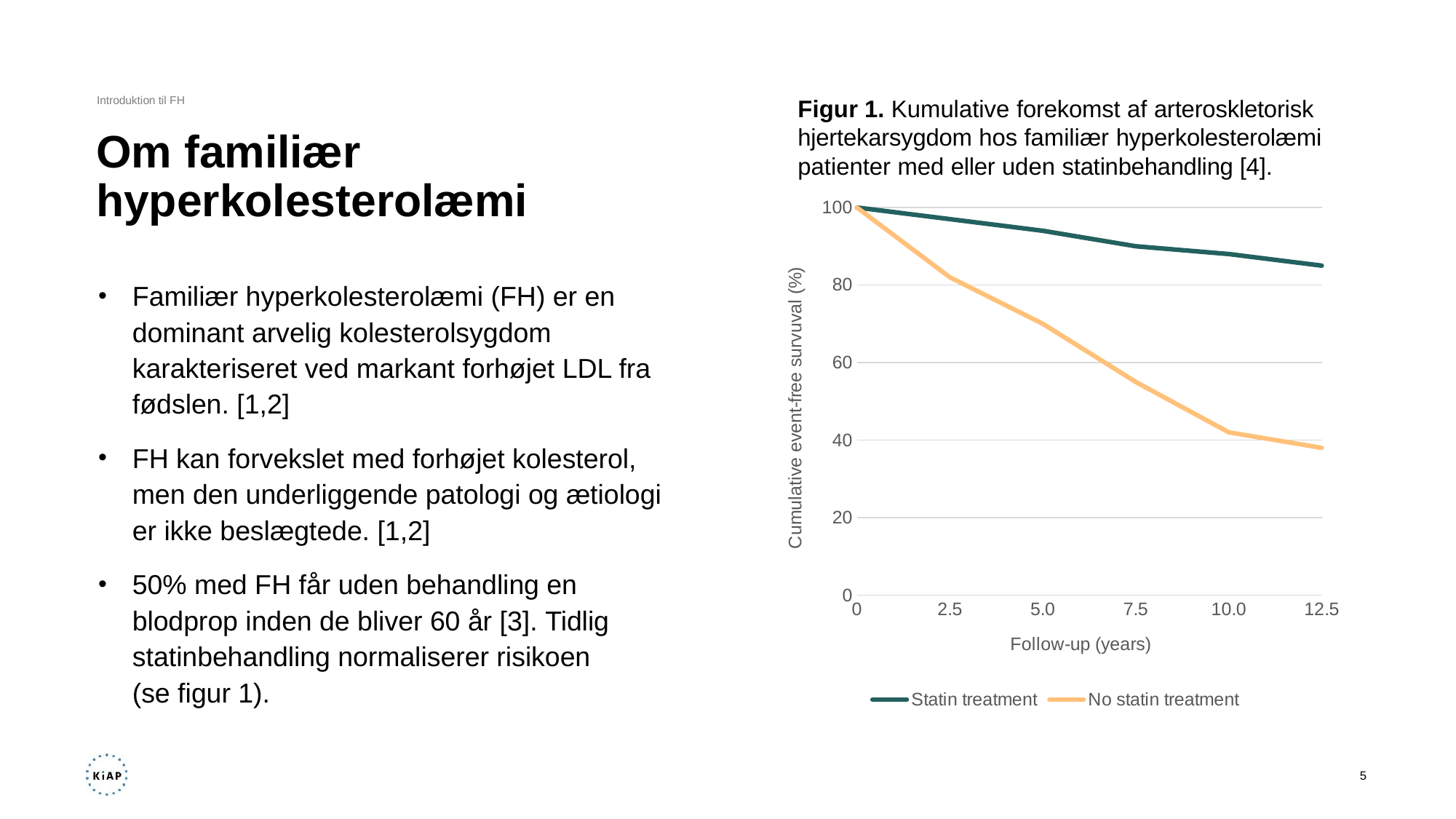
Is the value for No statin treatment at 5.0 years greater or less than 60? greater What is the cumulative event-free survival for both series at 0 years of follow-up? 100 How many series does the legend of the chart list? 2 Does the No statin treatment line rise or fall as follow-up years increase? Fall At 10.0 years of follow-up, which series has the higher cumulative event-free survival? Statin treatment What kind of chart is shown in Figur 1? Line chart Does the Statin treatment line rise or fall along the x axis? Fall Is the value for No statin treatment at 12.5 years greater or less than 40? less Which series has the lowest cumulative event-free survival at the end of follow-up (12.5 years)? No statin treatment Is the value for Statin treatment at 12.5 years greater or less than 80? greater What is the label of the x axis of the chart? Follow-up (years) Which two series are listed in the chart legend? Statin treatment and No statin treatment